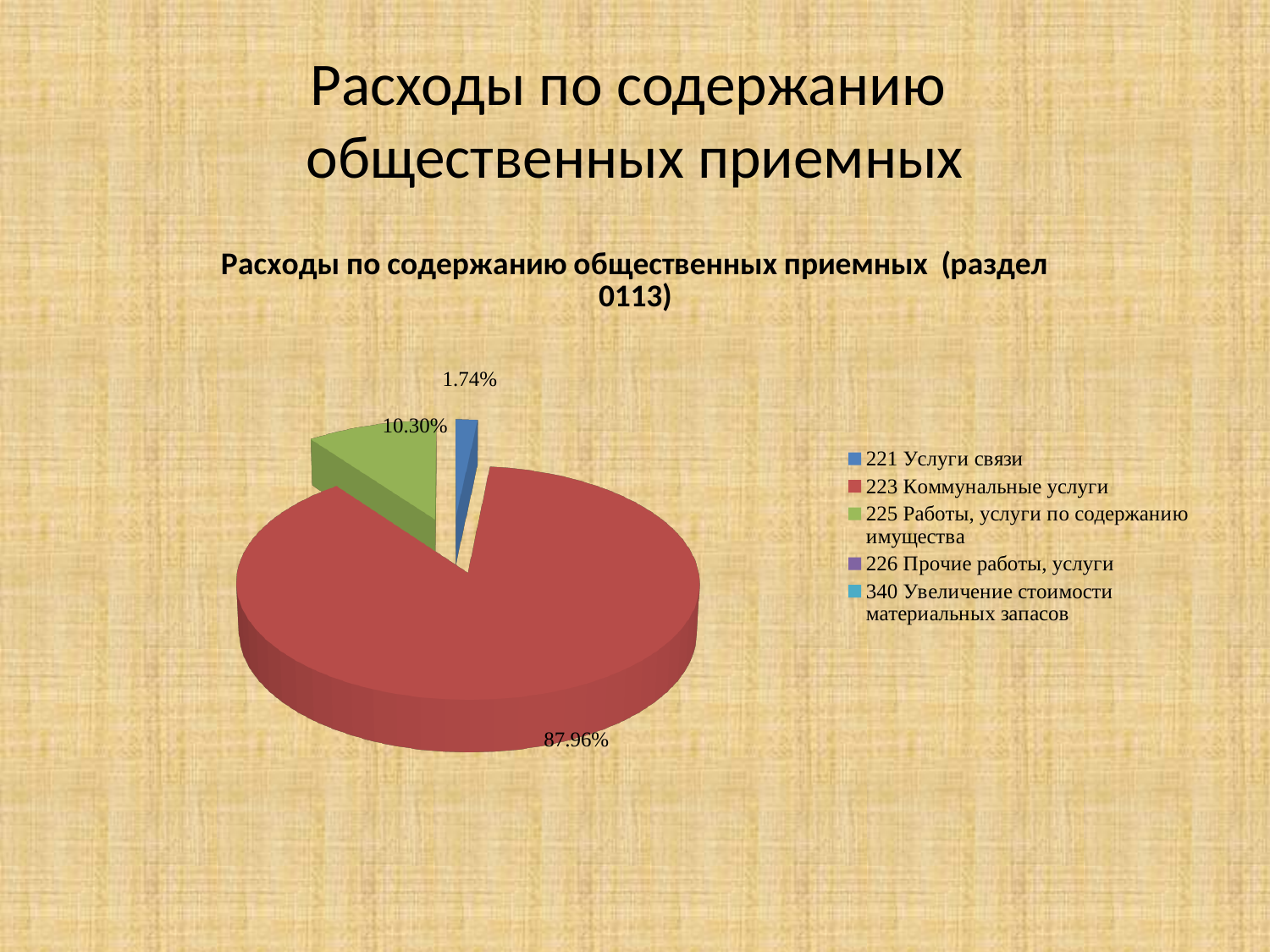
How many entries does the legend list? 5 What percentage is shown for 221 Услуги связи? 1.74% Which category has the largest slice of the pie? 223 Коммунальные услуги What percentage is shown for 225 Работы, услуги по содержанию имущества? 10.30% What is the difference in percentage points between the 223 Коммунальные услуги slice and the 221 Услуги связи slice? 86.22% What is the difference in percentage points between the 225 Работы, услуги по содержанию имущества slice and the 221 Услуги связи slice? 8.56% Which is larger, the slice for 225 Работы, услуги по содержанию имущества or the slice for 221 Услуги связи? 225 Работы, услуги по содержанию имущества What share of the pie does 223 Коммунальные услуги account for? 87.96% What is the title of the chart? Расходы по содержанию общественных приемных (раздел 0113) What is the difference in percentage points between the 223 Коммунальные услуги slice and the 225 Работы, услуги по содержанию имущества slice? 77.66% What kind of chart is shown on the slide? Pie chart What colour is the slice for 223 Коммунальные услуги? Red